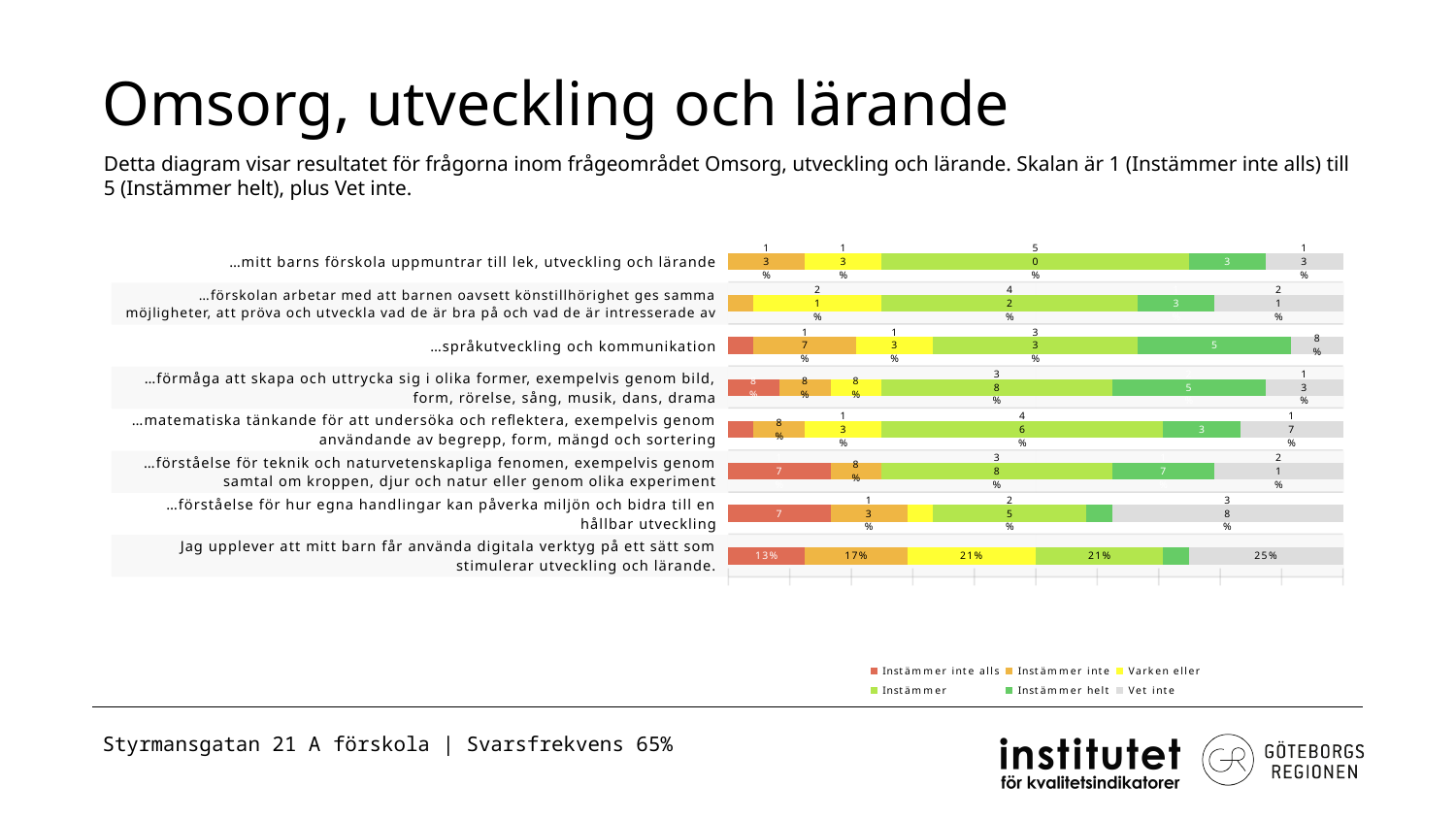
For the question "Jag upplever att mitt barn får använda digitala verktyg på ett sätt som stimulerar utveckling och lärande", what is the share for Vet inte? 25% Which colour represents Vet inte in the legend? Grey For the question about digitala verktyg, which is larger: the share for Instämmer inte or the share for Instämmer inte alls? Instämmer inte For the question about digitala verktyg, which response category has the largest share? Vet inte For the question "Jag upplever att mitt barn får använda digitala verktyg på ett sätt som stimulerar utveckling och lärande", what is the share for Instämmer inte? 17% How many series does the legend list? 6 For the question "Jag upplever att mitt barn får använda digitala verktyg på ett sätt som stimulerar utveckling och lärande", what is the share for Instämmer inte alls? 13% How many questions (categories) are plotted in the chart? 8 For the question "…mitt barns förskola uppmuntrar till lek, utveckling och lärande", what is the share for Instämmer? 50% For the question "Jag upplever att mitt barn får använda digitala verktyg på ett sätt som stimulerar utveckling och lärande", what is the share for Varken eller? 21% What kind of chart is shown on the slide? Stacked bar chart For the question about digitala verktyg, what is the difference between the Vet inte share and the Instämmer inte alls share? 12 percentage points